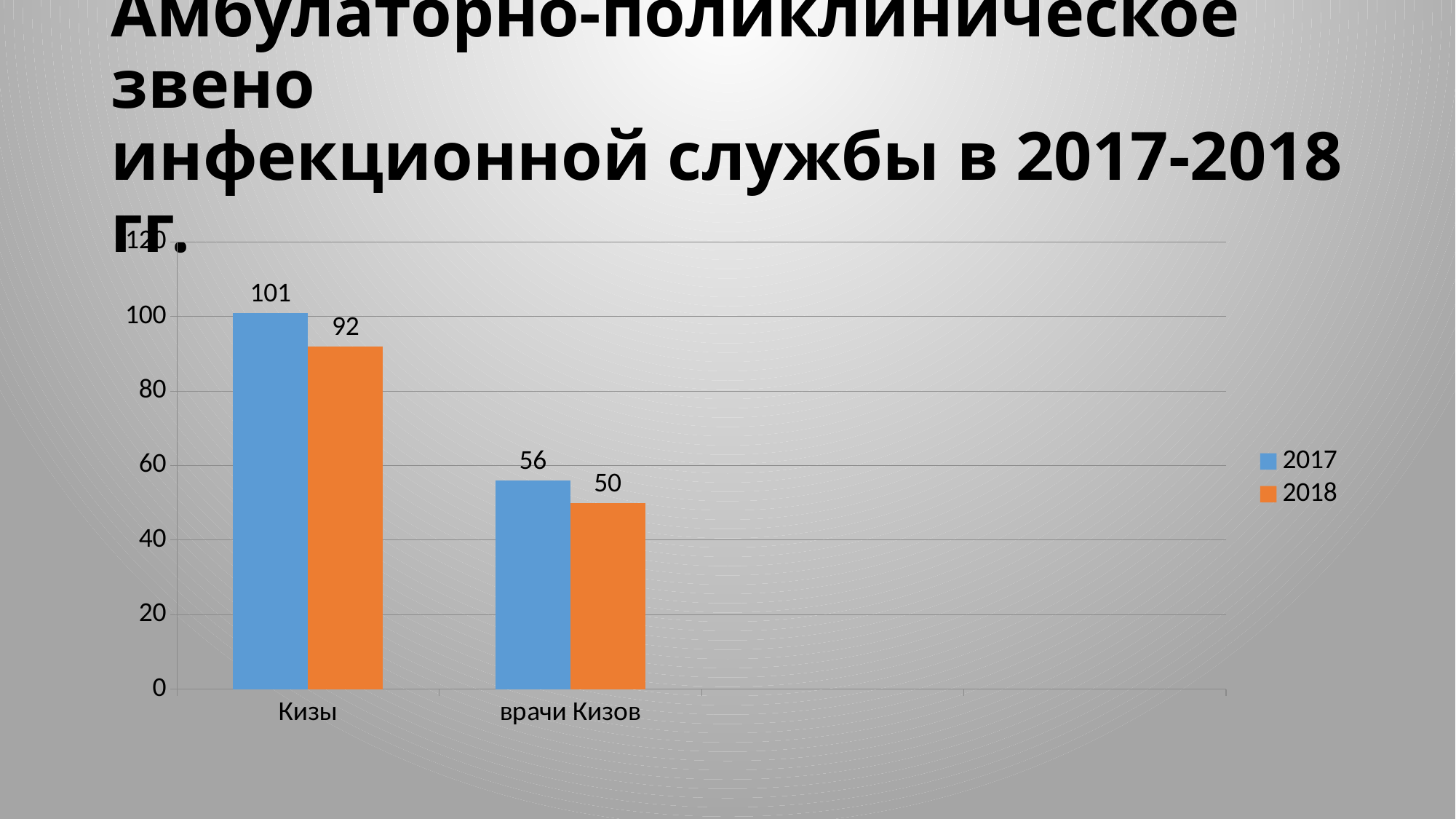
What is the value for врачи Кизов in 2017? 56 Which is larger for врачи Кизов: the 2017 value or the 2018 value? 2017 Which category has the lowest value in the 2018 series? врачи Кизов What is the value for врачи Кизов in 2018? 50 Which category has the highest value in the 2017 series? Кизы How many series does the legend list? 2 What is the difference between the 2017 and 2018 values for Кизы? 9 How many categories are shown on the x axis? 2 What is the difference between the 2017 and 2018 values for врачи Кизов? 6 What is the value for Кизы in 2018? 92 What is the value for Кизы in 2017? 101 What kind of chart is shown on the slide? bar chart